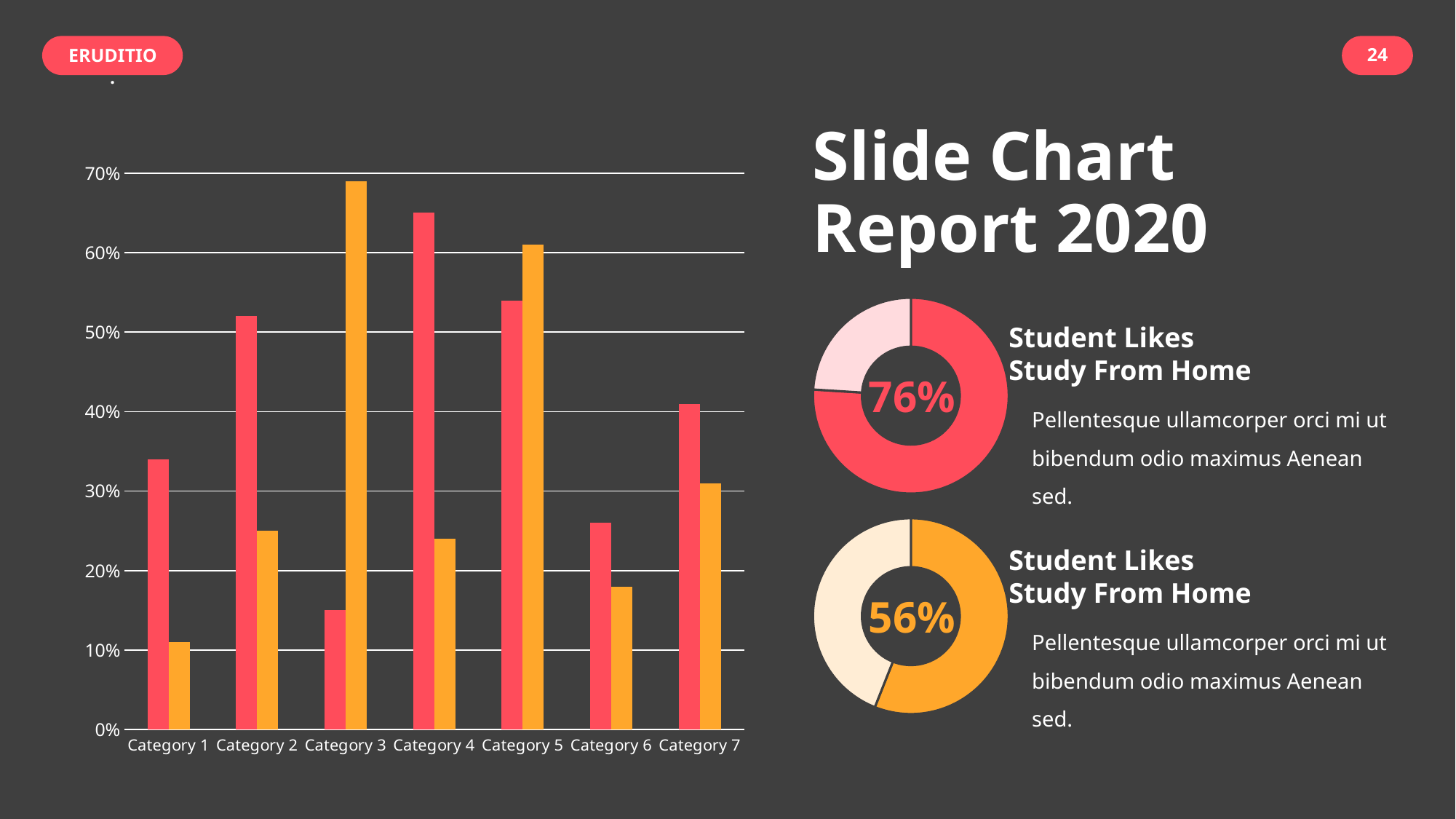
What percentage is shown in the bottom donut chart on the right? 56% In the bar chart, which category has the shortest orange bar? Category 1 What percentage is shown in the top donut chart on the right? 76% In the bar chart, which category has the shortest red bar? Category 3 In the bar chart, is the red bar for Category 1 greater or less than 30%? greater What kind of chart is shown on the left side of the slide? bar chart In the bar chart, for Category 5, which bar is taller, the red one or the orange one? orange In the bar chart, which category has the tallest red bar? Category 4 In the bar chart, is the red bar for Category 6 greater or less than 30%? less How many categories are shown on the x axis of the bar chart? 7 In the bar chart, is the orange bar for Category 2 greater or less than 30%? less In the bar chart, which category has the tallest orange bar? Category 3